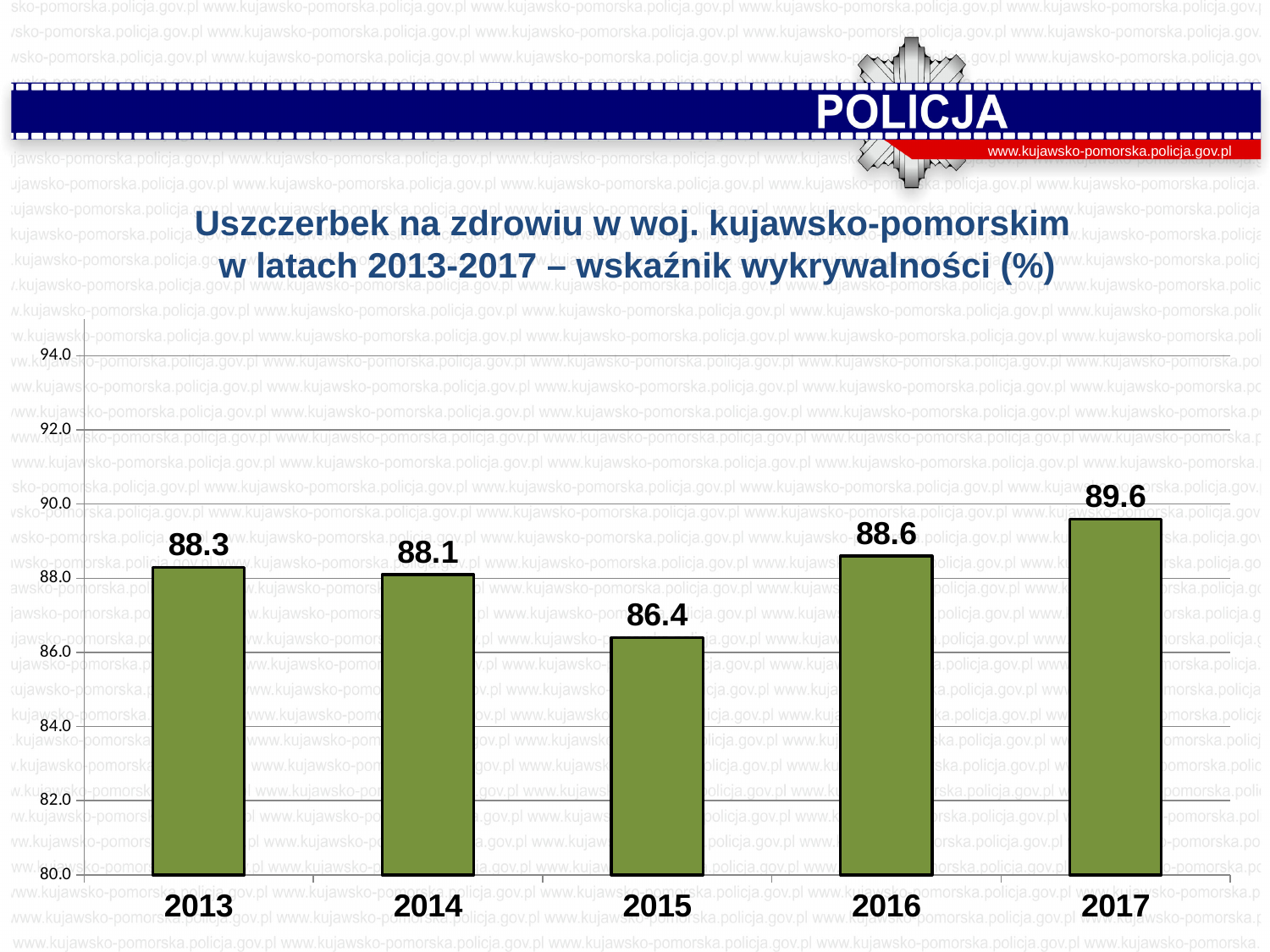
What is the value for 2013? 88.3 What kind of chart is shown? bar chart Is the value for 2016 greater or less than 88.0? greater Which is larger, the value for 2014 or the value for 2016? 2016 What is the value for 2017? 89.6 Do the values rise or fall from 2015 to 2017? rise Which year has the highest value? 2017 What is the difference between the values for 2013 and 2014? 0.2 What is the difference between the values for 2017 and 2015? 3.2 How many years are shown on the x axis? 5 What is the value for 2015? 86.4 Which year has the lowest value? 2015